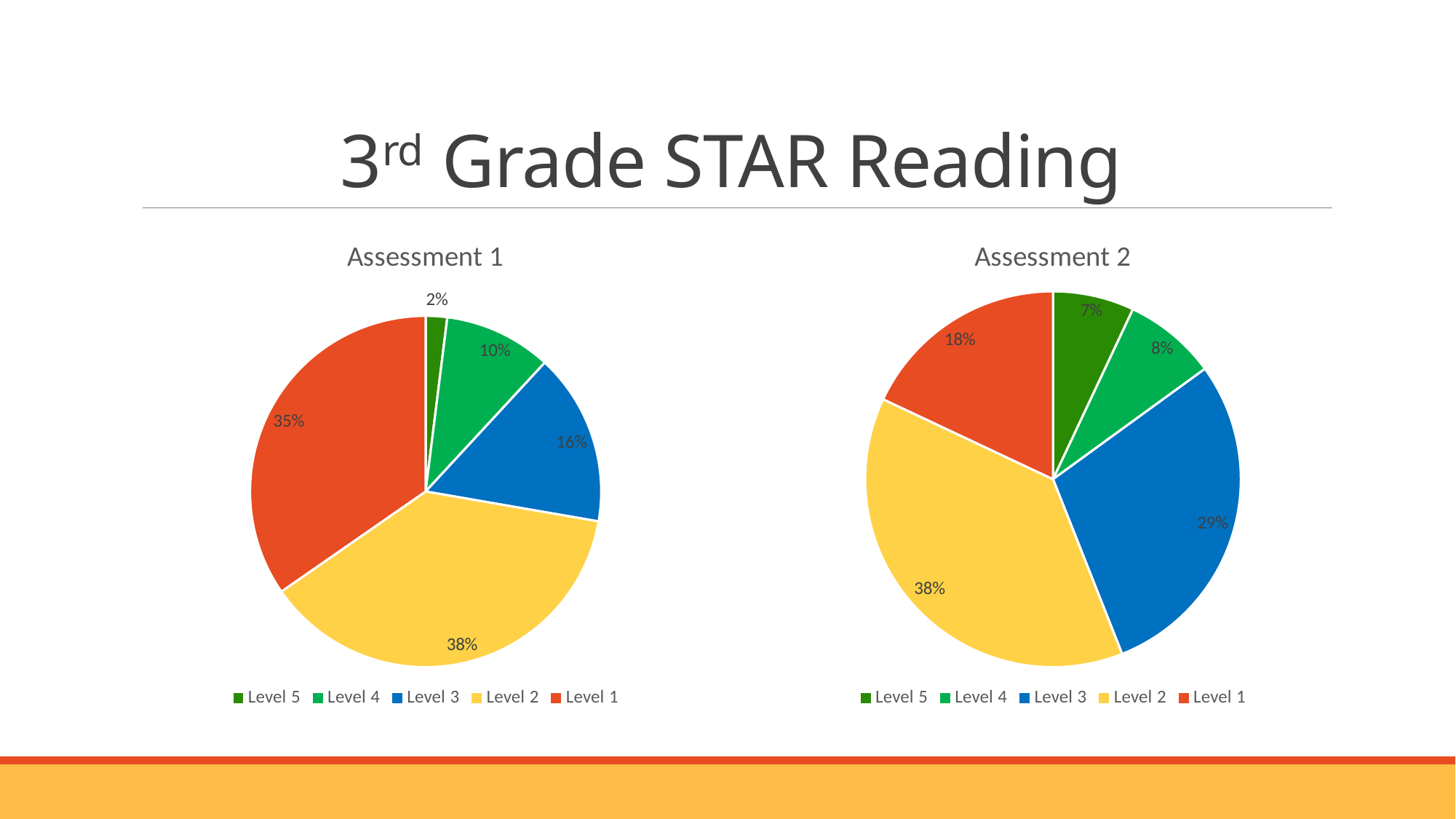
In the Assessment 1 chart, what percentage is shown for Level 5? 2% In the Assessment 1 chart, what percentage is shown for Level 3? 16% What is the difference between the Level 1 share in Assessment 1 and the Level 1 share in Assessment 2? 17% In the Assessment 2 chart, what percentage is shown for Level 3? 29% In the Assessment 1 chart, what colour represents Level 2? Yellow What type of chart is used for Assessment 2? Pie chart In the Assessment 2 chart, which level has the smallest share? Level 5 How many levels are shown in the Assessment 1 pie chart? 5 In the Assessment 2 chart, which is larger, the share for Level 3 or the share for Level 1? Level 3 In the Assessment 1 chart, which level has the largest share? Level 2 In the Assessment 1 chart, which level has the smallest share? Level 5 In the Assessment 2 chart, what percentage is shown for Level 1? 18%